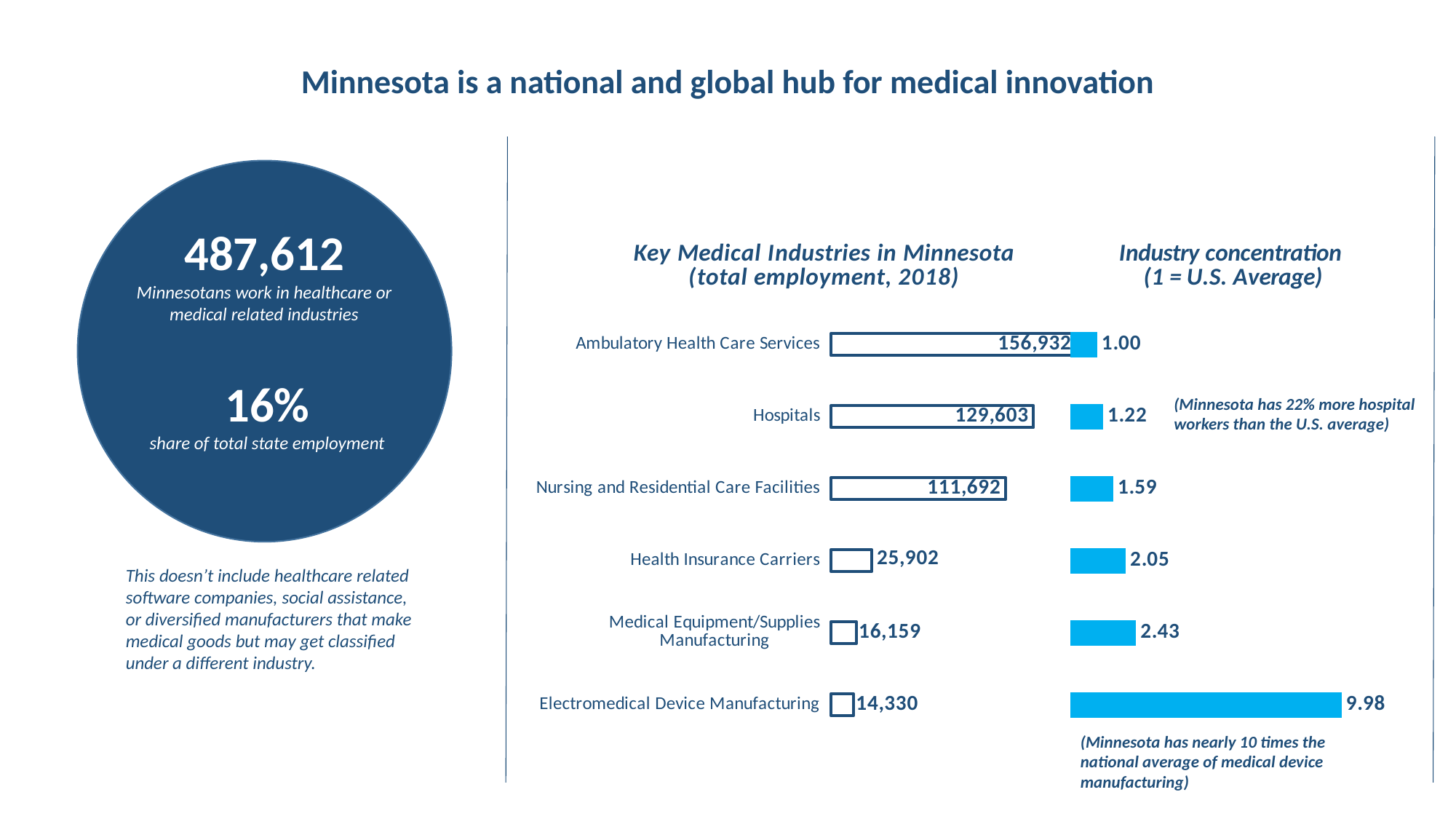
In the 'Industry concentration (1 = U.S. Average)' chart, which is larger: the value for Hospitals or the value for Nursing and Residential Care Facilities? Nursing and Residential Care Facilities In the 'Industry concentration (1 = U.S. Average)' chart, what is the value for Health Insurance Carriers? 2.05 In the 'Industry concentration (1 = U.S. Average)' chart, what is the difference between the values for Medical Equipment/Supplies Manufacturing and Health Insurance Carriers? 0.38 In the 'Key Medical Industries in Minnesota (total employment, 2018)' chart, how many industries are shown? 6 In the 'Key Medical Industries in Minnesota (total employment, 2018)' chart, what is the difference in employment between Ambulatory Health Care Services and Hospitals? 27,329 What kind of chart is the 'Key Medical Industries in Minnesota (total employment, 2018)' chart? Bar chart In the 'Key Medical Industries in Minnesota (total employment, 2018)' chart, what is the total employment for Hospitals? 129,603 In the 'Industry concentration (1 = U.S. Average)' chart, which industry has the lowest concentration value? Ambulatory Health Care Services In the 'Industry concentration (1 = U.S. Average)' chart, what is the value for Electromedical Device Manufacturing? 9.98 In the 'Key Medical Industries in Minnesota (total employment, 2018)' chart, which industry has the lowest total employment? Electromedical Device Manufacturing In the 'Key Medical Industries in Minnesota (total employment, 2018)' chart, which industry has the highest total employment? Ambulatory Health Care Services In the 'Key Medical Industries in Minnesota (total employment, 2018)' chart, what is the total employment for Medical Equipment/Supplies Manufacturing? 16,159